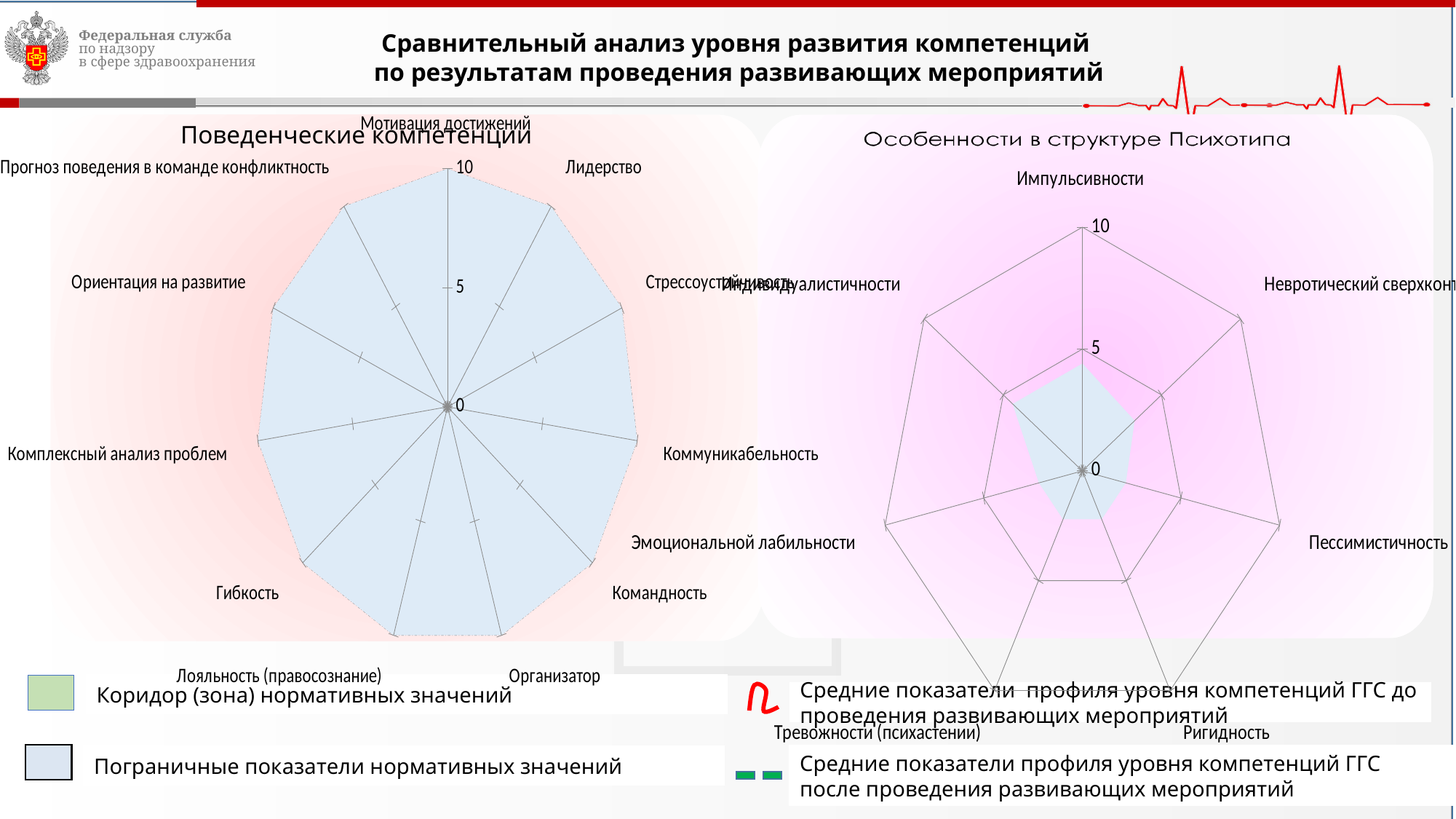
In the "Поведенческие компетенции" chart, is the value for Коммуникабельность greater or less than 5? greater What is the title of the radar chart on the right side of the slide? Особенности в структуре Психотипа What kind of chart is the "Поведенческие компетенции" chart on the left? Radar chart How many categories (axes) does the "Особенности в структуре Психотипа" chart have? 7 What kind of chart is the "Особенности в структуре Психотипа" chart on the right? Radar chart In the "Поведенческие компетенции" chart, what is the maximum value shown on the radial axis? 10 How many categories (axes) does the "Поведенческие компетенции" chart have? 11 In the "Поведенческие компетенции" chart, is the value for Гибкость greater or less than 5? greater In the "Поведенческие компетенции" chart, is the value for Лидерство greater or less than 5? greater